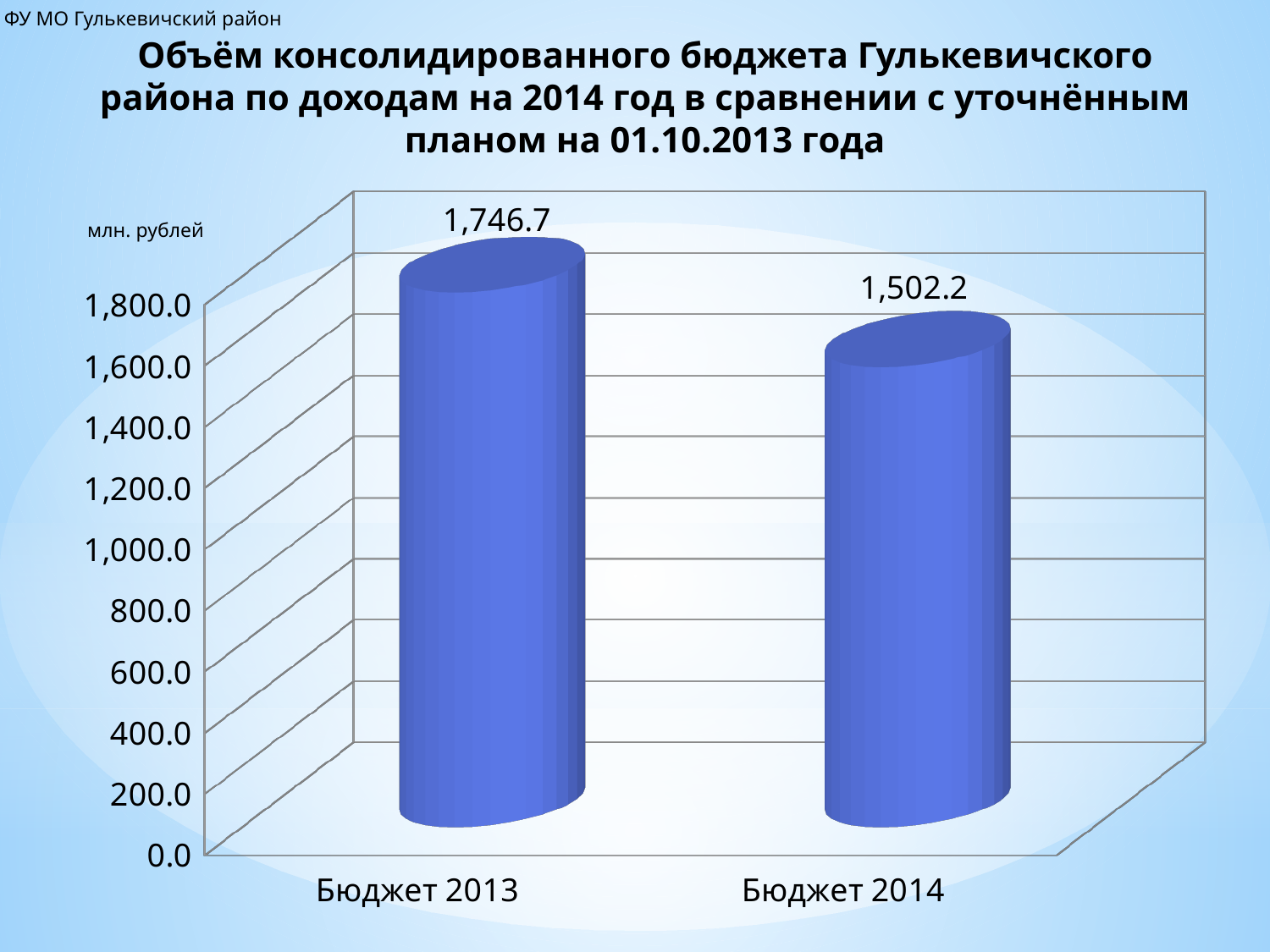
Is the value for Бюджет 2013 greater or less than 1,600.0? greater How many categories are shown on the chart? 2 Which is larger, the value for Бюджет 2013 or Бюджет 2014? Бюджет 2013 What is the difference between the values for Бюджет 2013 and Бюджет 2014? 244.5 What is the value for Бюджет 2014? 1,502.2 Do the values rise or fall from Бюджет 2013 to Бюджет 2014? fall What unit is indicated for the values on the chart? млн. рублей What is the value for Бюджет 2013? 1,746.7 What kind of chart is shown on the slide? bar chart Which category has the lowest value? Бюджет 2014 Is the value for Бюджет 2014 greater or less than 1,600.0? less Which category has the highest value? Бюджет 2013